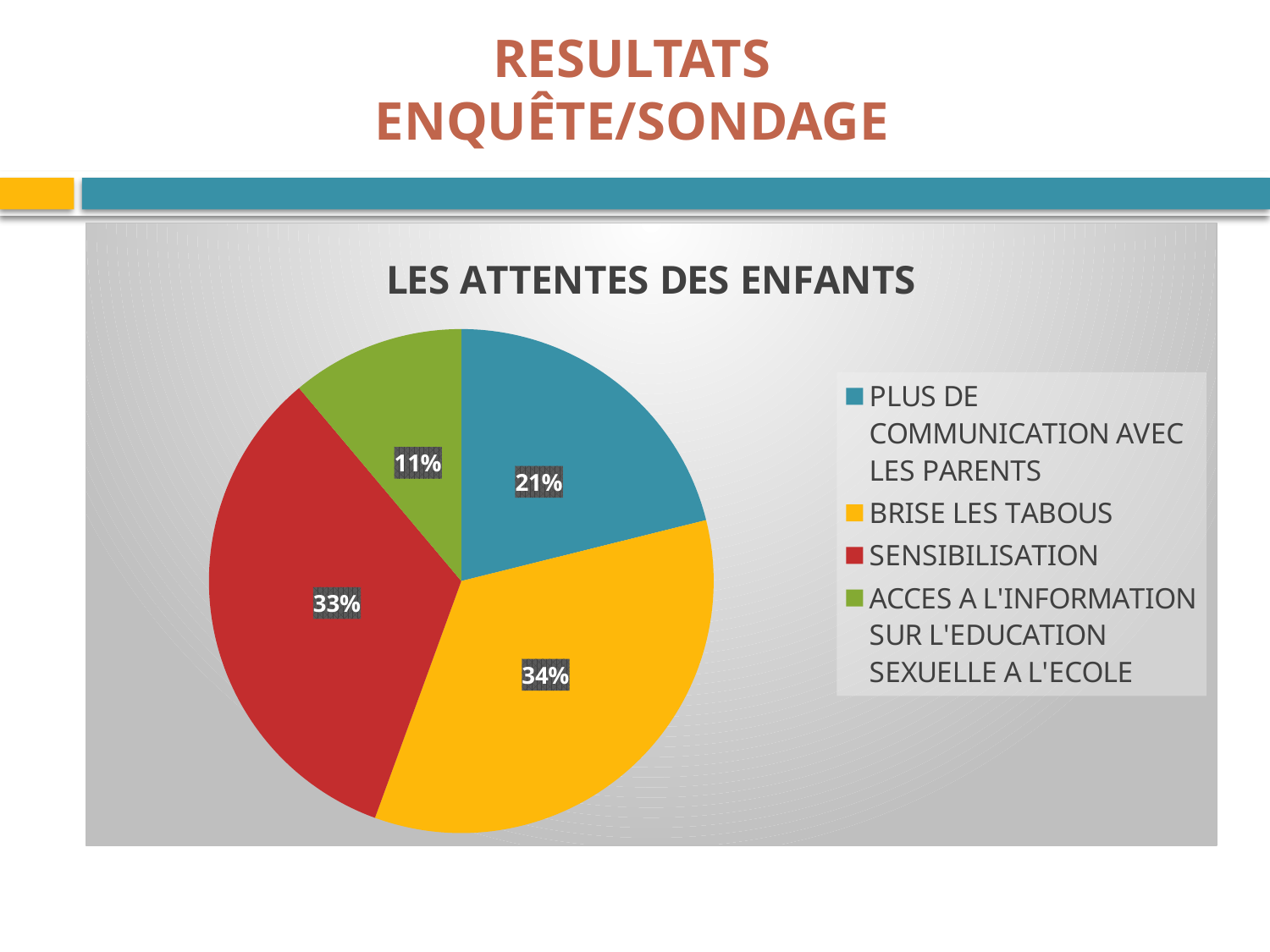
What percentage of the pie is labelled for SENSIBILISATION? 33% What percentage of the pie is labelled for BRISE LES TABOUS? 34% How many categories does the pie chart show? 4 Which category has the smallest slice of the pie? ACCES A L'INFORMATION SUR L'EDUCATION SEXUELLE A L'ECOLE What is the difference in percentage points between the SENSIBILISATION slice and the PLUS DE COMMUNICATION AVEC LES PARENTS slice? 12 Which slice is larger: PLUS DE COMMUNICATION AVEC LES PARENTS or ACCES A L'INFORMATION SUR L'EDUCATION SEXUELLE A L'ECOLE? PLUS DE COMMUNICATION AVEC LES PARENTS What colour is the SENSIBILISATION slice in the pie chart? Red Which category has the largest slice of the pie? BRISE LES TABOUS What percentage of the pie is labelled for PLUS DE COMMUNICATION AVEC LES PARENTS? 21% What type of chart is shown on the slide? Pie chart What is the title of the chart? LES ATTENTES DES ENFANTS What percentage of the pie is labelled for ACCES A L'INFORMATION SUR L'EDUCATION SEXUELLE A L'ECOLE? 11%